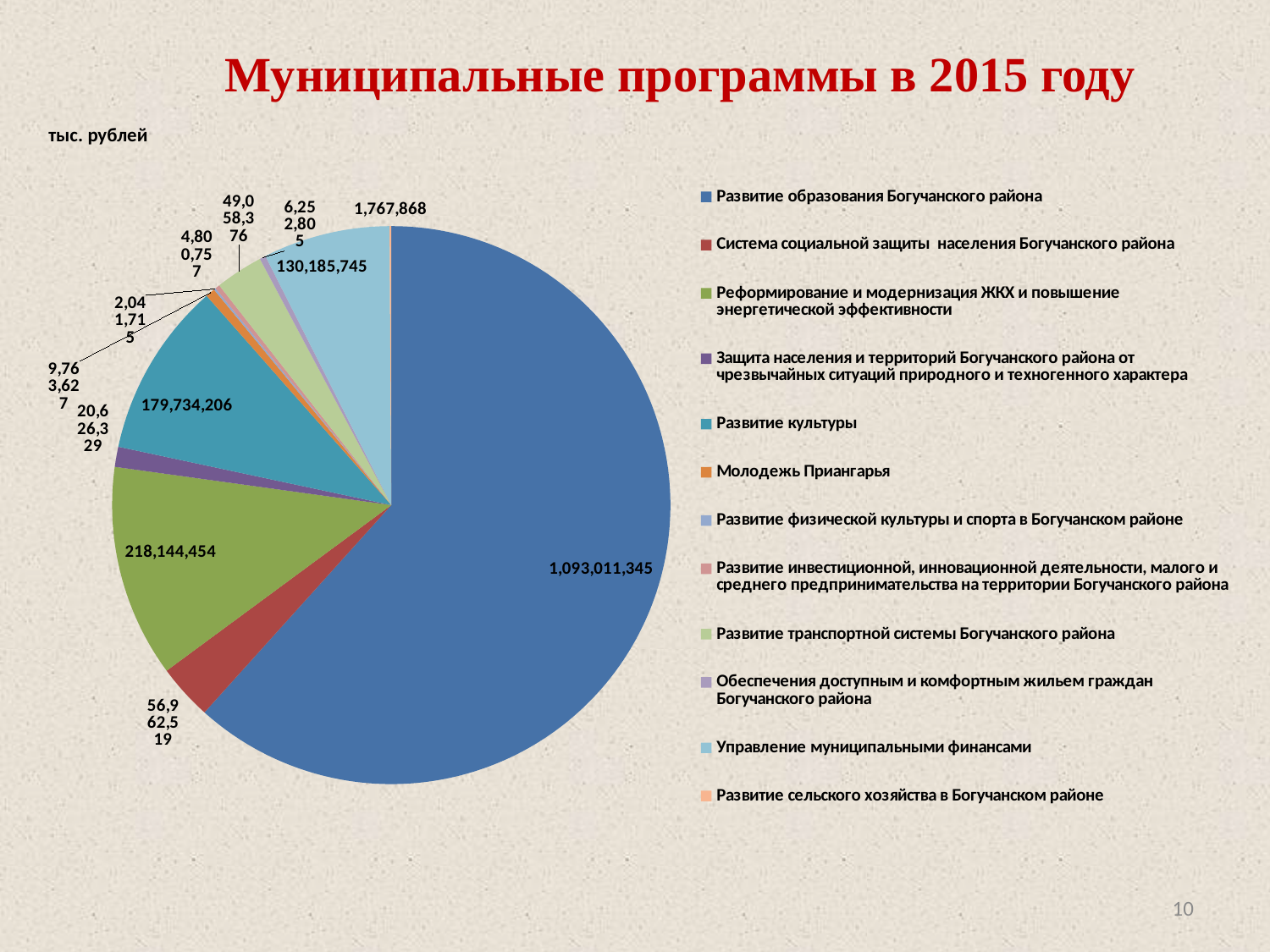
What is the difference between the values for Реформирование и модернизация ЖКХ and Развитие культуры? 38,410,248 How many entries does the legend of the pie chart list? 12 Which is larger: the value for Реформирование и модернизация ЖКХ или Развитие культуры? Реформирование и модернизация ЖКХ и повышение энергетической эффективности In what units are the values on the chart given, according to the slide? тыс. рублей Which program has the largest slice of the pie? Развитие образования Богучанского района What is the value for Развитие образования Богучанского района? 1,093,011,345 What is the value for Развитие сельского хозяйства в Богучанском районе? 1,767,868 What is the value for Развитие культуры? 179,734,206 What is the value for Управление муниципальными финансами? 130,185,745 What kind of chart is shown on the slide? pie chart What is the difference between the values for Развитие образования Богучанского района and Реформирование и модернизация ЖКХ? 874,866,891 What is the value for Реформирование и модернизация ЖКХ и повышение энергетической эффективности? 218,144,454